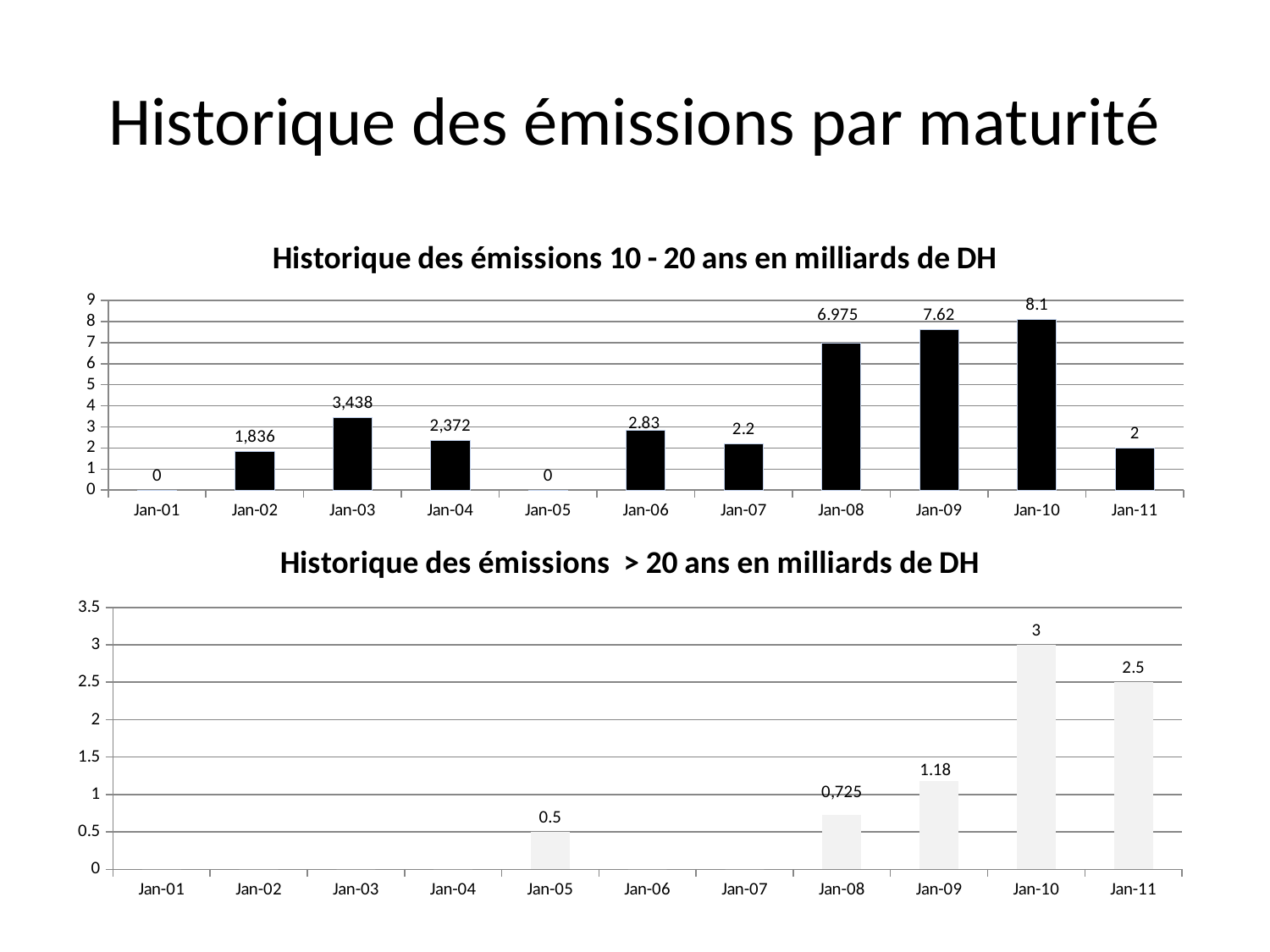
In the top chart (Historique des émissions 10 - 20 ans), what is the difference between the values for Jan-10 and Jan-09? 0.48 What kind of chart is the bottom chart (Historique des émissions > 20 ans)? Bar chart What is the title of the top chart? Historique des émissions 10 - 20 ans en milliards de DH In the top chart (Historique des émissions 10 - 20 ans), what is the value for Jan-08? 6.975 In the bottom chart (Historique des émissions > 20 ans), which year has the highest value? Jan-10 In the top chart (Historique des émissions 10 - 20 ans), how many years are shown on the x axis? 11 In the bottom chart (Historique des émissions > 20 ans), what is the difference between the values for Jan-10 and Jan-11? 0.5 In the bottom chart (Historique des émissions > 20 ans), is the value for Jan-11 greater or less than 2? greater In the bottom chart (Historique des émissions > 20 ans), what is the value for Jan-09? 1.18 In the top chart (Historique des émissions 10 - 20 ans), what is the value for Jan-10? 8.1 In the top chart (Historique des émissions 10 - 20 ans), which is larger, the value for Jan-06 or the value for Jan-07? Jan-06 In the top chart (Historique des émissions 10 - 20 ans), which year has the highest value? Jan-10